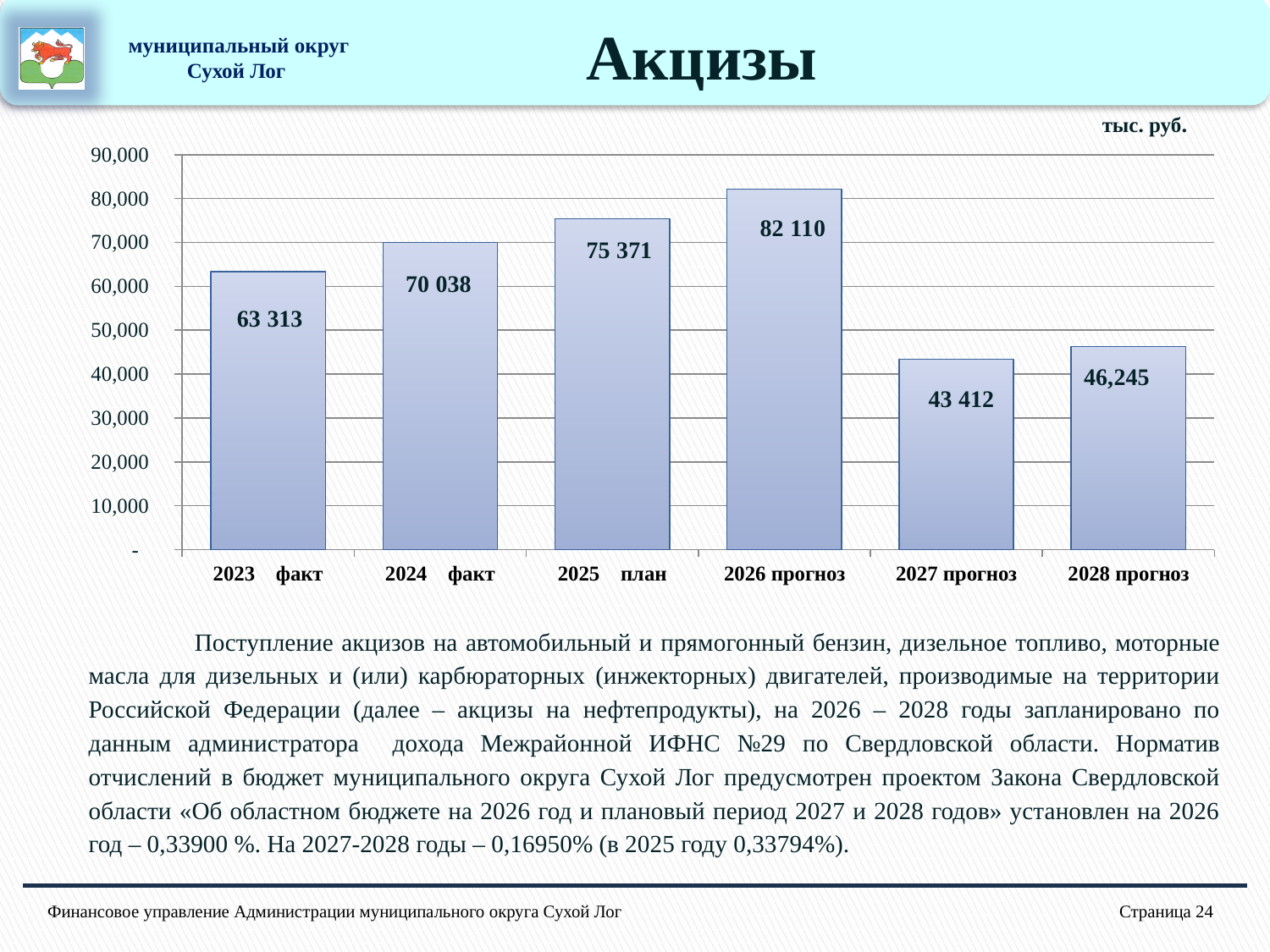
What is the difference between the values for 2024 факт and 2023 факт? 6 725 Which category has the lowest value? 2027 прогноз What is the difference between the values for 2026 прогноз and 2025 план? 6 739 Which category has the highest value? 2026 прогноз What kind of chart is shown on the slide? bar chart What is the value for 2026 прогноз? 82 110 Is the value for 2024 факт greater or less than 60,000? greater What is the value for 2023 факт? 63 313 How many categories are shown on the x axis? 6 What is the value for 2028 прогноз? 46,245 Which is larger, the value for 2025 план or the value for 2027 прогноз? 2025 план What unit is indicated above the chart? тыс. руб.